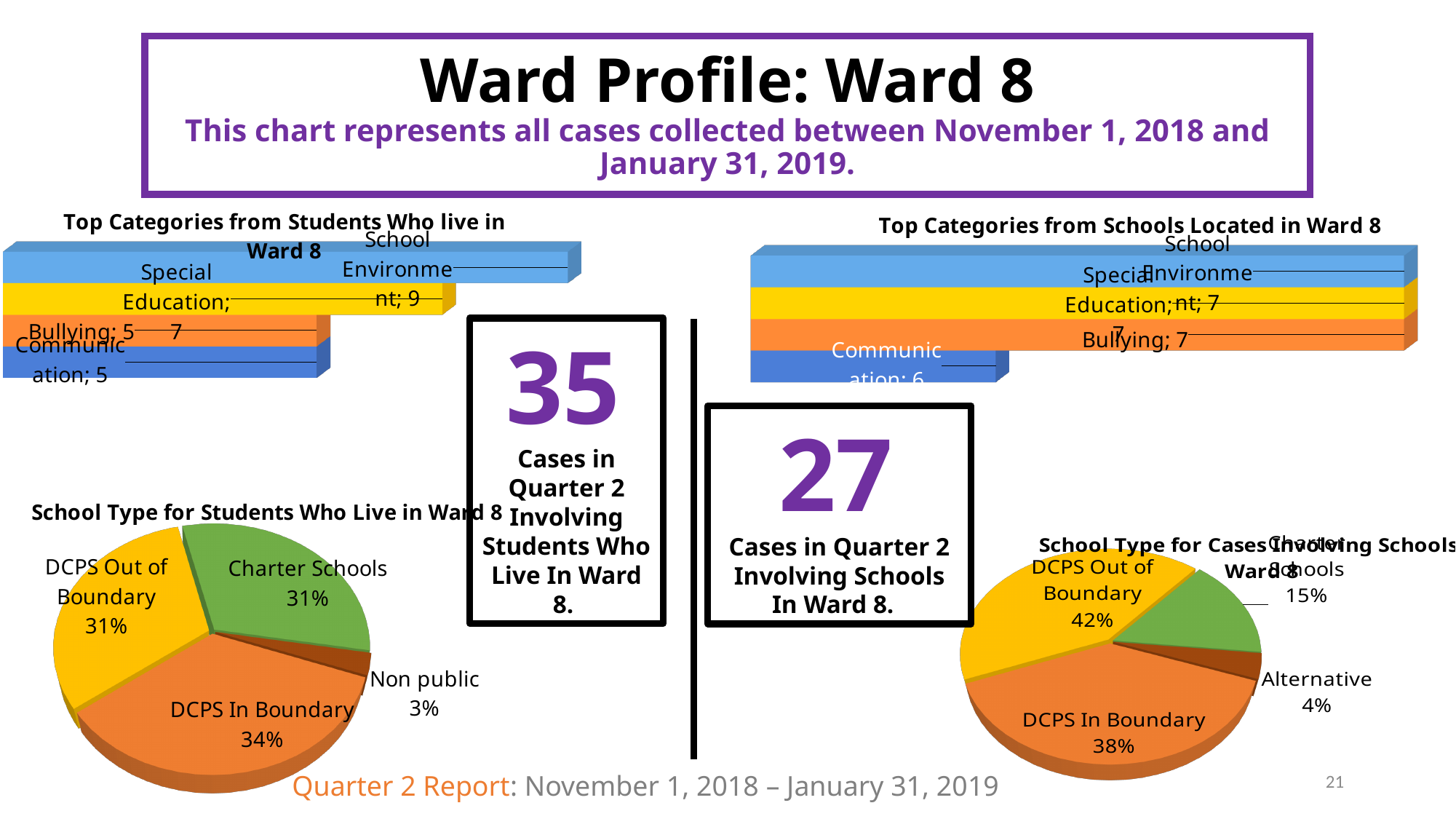
In the 'Top Categories from Schools Located in Ward 8' chart, what is the value for Communication? 6 In the 'Top Categories from Students Who live in Ward 8' chart, what is the difference between School Environment and Bullying? 4 How many categories are shown in the 'Top Categories from Schools Located in Ward 8' chart? 4 In the 'Top Categories from Schools Located in Ward 8' chart, which category has the lowest value? Communication In the 'School Type for Students Who Live in Ward 8' pie chart, which school type has the smallest share? Non public In the 'School Type for Cases Involving Schools in Ward 8' pie chart, what share is DCPS Out of Boundary? 42% In the 'School Type for Cases Involving Schools in Ward 8' pie chart, what is the difference between DCPS Out of Boundary and Alternative? 38% What kind of chart is 'Top Categories from Students Who live in Ward 8'? Bar chart In the 'School Type for Cases Involving Schools in Ward 8' pie chart, which is larger: Charter Schools or DCPS In Boundary? DCPS In Boundary In the 'Top Categories from Students Who live in Ward 8' chart, which category has the highest value? School Environment In the 'Top Categories from Students Who live in Ward 8' chart, what is the value for School Environment? 9 In the 'School Type for Students Who Live in Ward 8' pie chart, what share is DCPS In Boundary? 34%